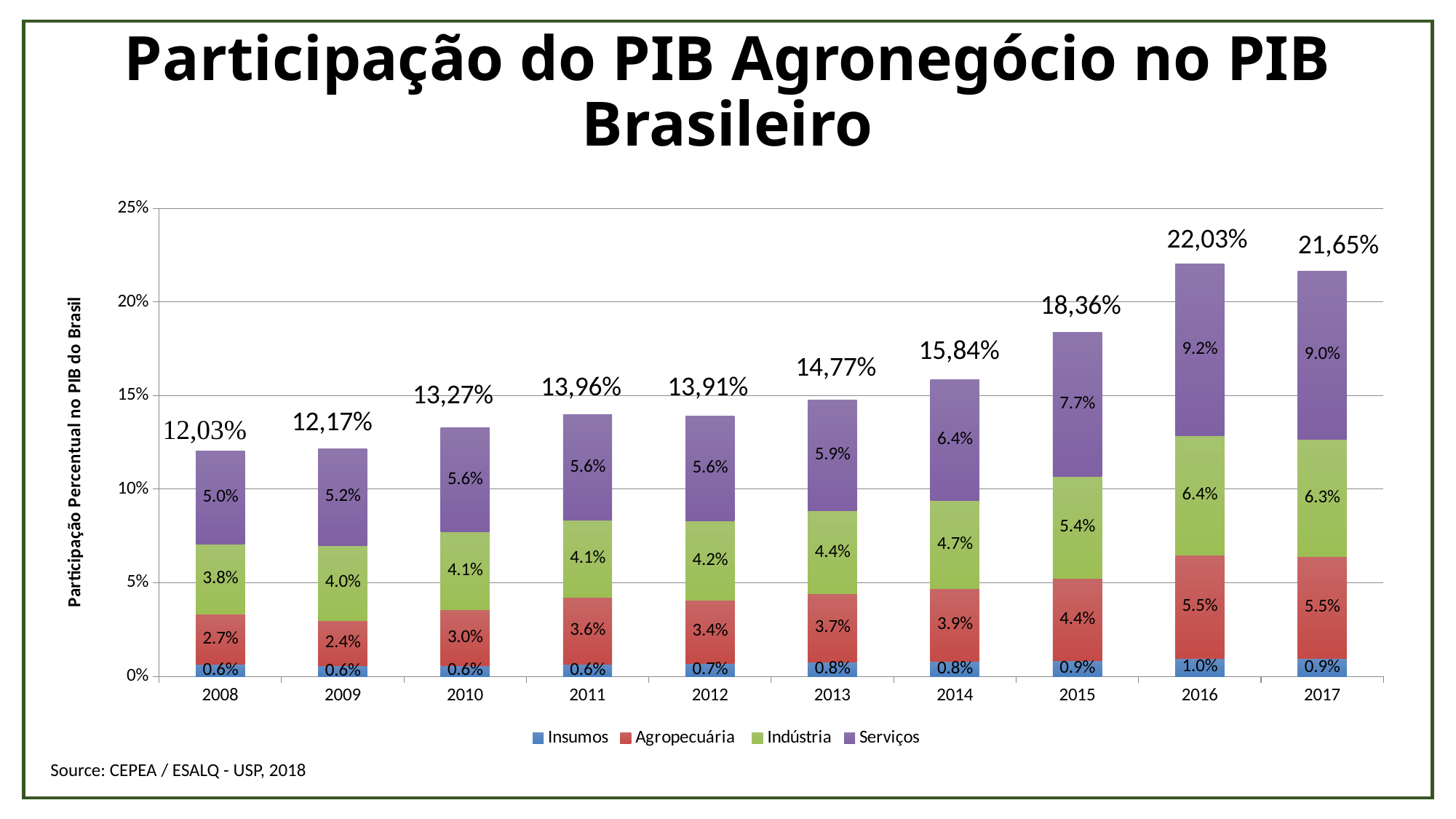
In 2015, which is larger: Agropecuária or Indústria? Indústria Which year has the lowest total participation? 2008 What is the value of Agropecuária in 2011? 3.6% What is the value of Serviços in 2016? 9.2% What is the total of the stacked bar for 2016? 22,03% What is the difference between the Indústria value in 2016 and in 2008? 2.6% What is the value of Insumos in 2016? 1.0% What kind of chart is shown on the slide? Stacked bar chart How many series does the legend list? 4 How many years are shown on the x axis? 10 Do the total values generally rise or fall from 2008 to 2017? Rise Which year has the highest total participation? 2016